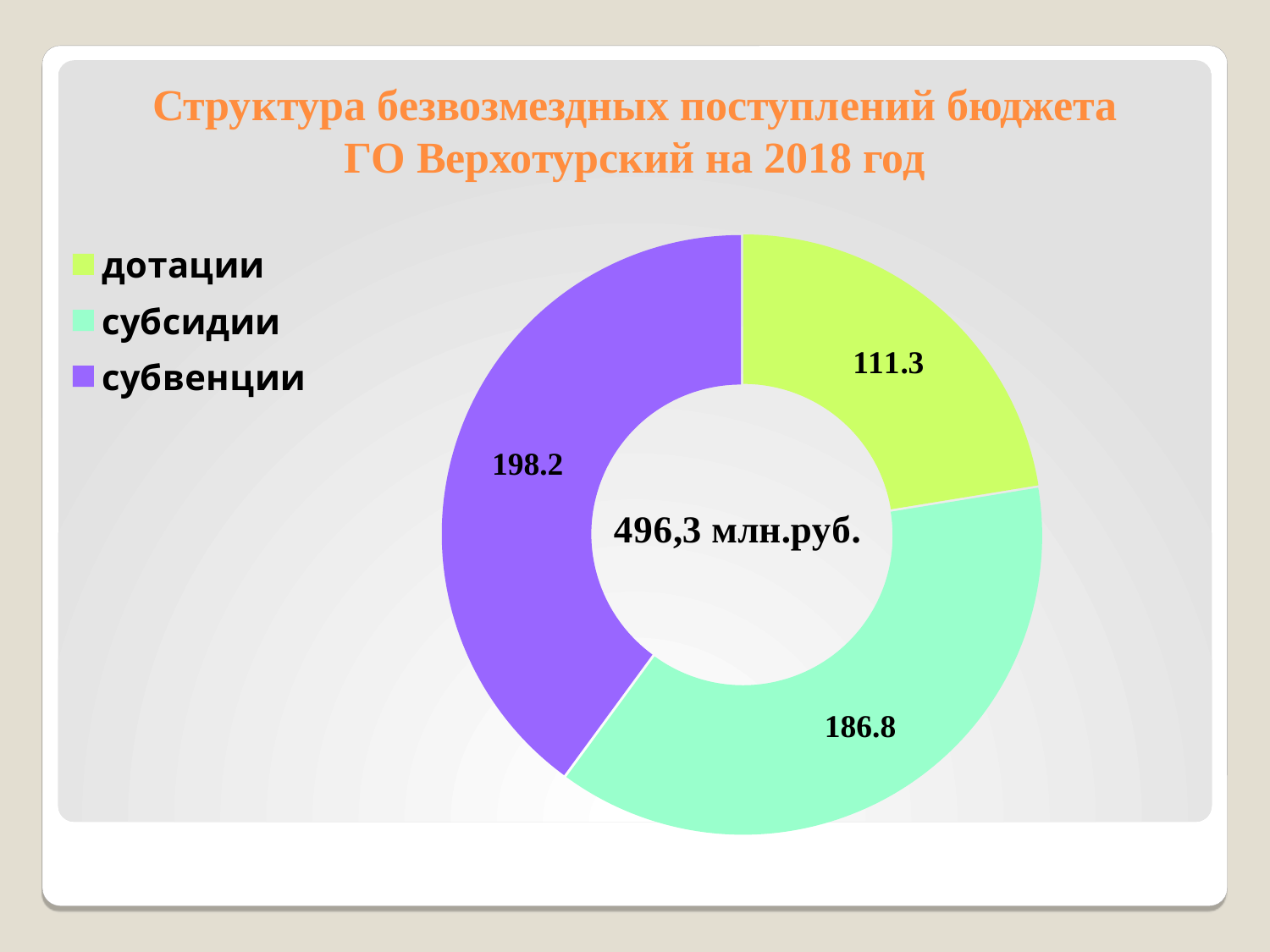
What is the value for субвенции? 198.2 What colour is the slice for субвенции? Purple What is the value for субсидии? 186.8 What is the difference between the values for субсидии and дотации? 75.5 Which is larger, the value for субсидии or the value for дотации? субсидии What is the difference between the values for субвенции and субсидии? 11.4 Which category has the largest value? субвенции How many categories does the chart show? 3 What total is printed in the centre of the chart? 496,3 млн.руб. What kind of chart is shown on the slide? Doughnut (pie) chart Which category has the smallest value? дотации What is the value for дотации? 111.3